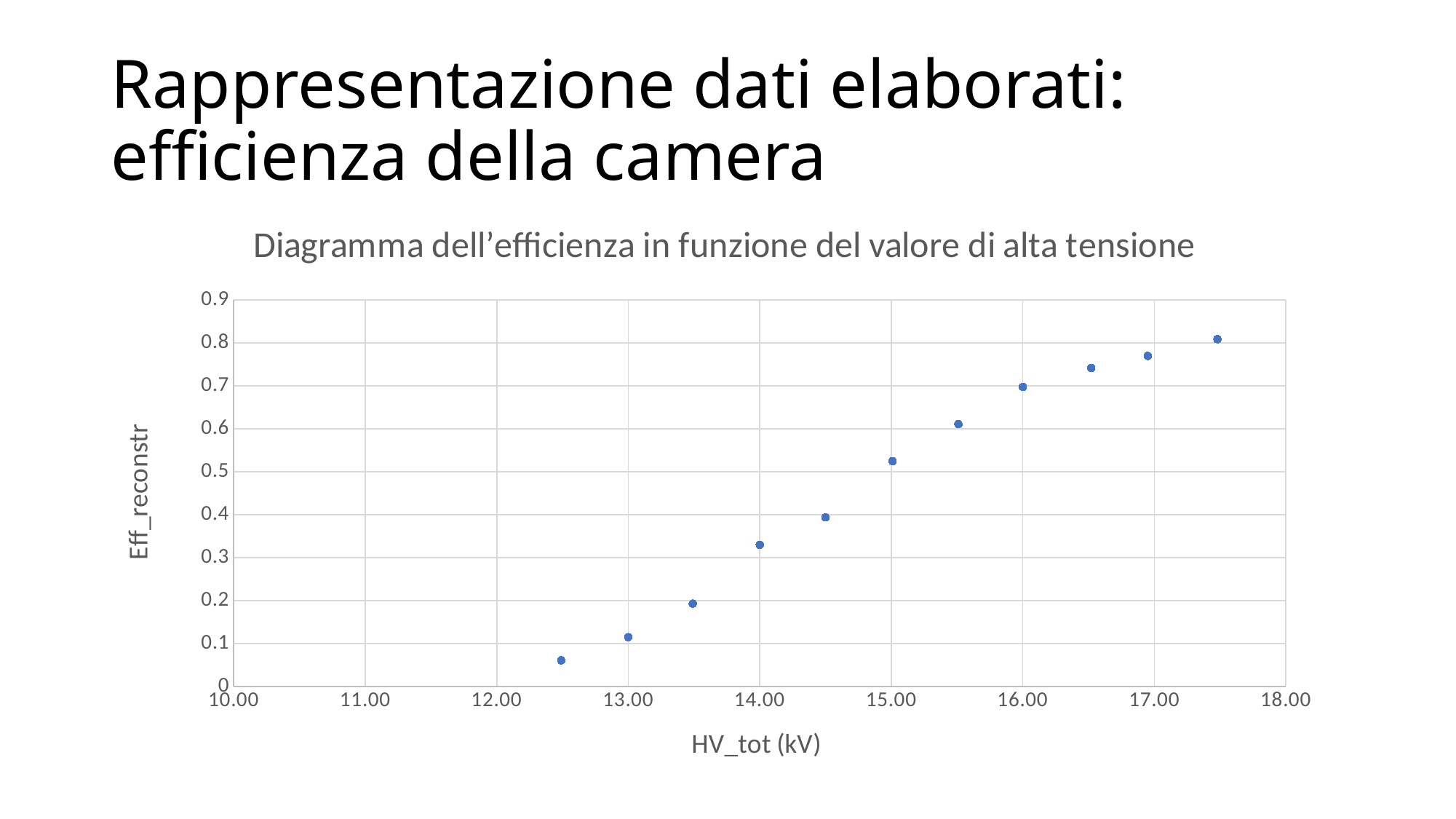
Is the Eff_reconstr value at HV_tot = 17.00 kV greater or less than 0.8? less Is the Eff_reconstr value at HV_tot = 14.00 kV greater or less than 0.3? greater How many data points are plotted in the chart? 11 Is the Eff_reconstr value at HV_tot = 13.00 kV greater or less than 0.2? less Which has the larger Eff_reconstr value: the point at HV_tot = 15.00 kV or the point at HV_tot = 14.00 kV? 15.00 kV What is the title of the chart? Diagramma dell'efficienza in funzione del valore di alta tensione What kind of chart is shown on the slide? scatter chart Do the Eff_reconstr values rise or fall as HV_tot increases? rise What is the label of the x axis of the chart? HV_tot (kV)